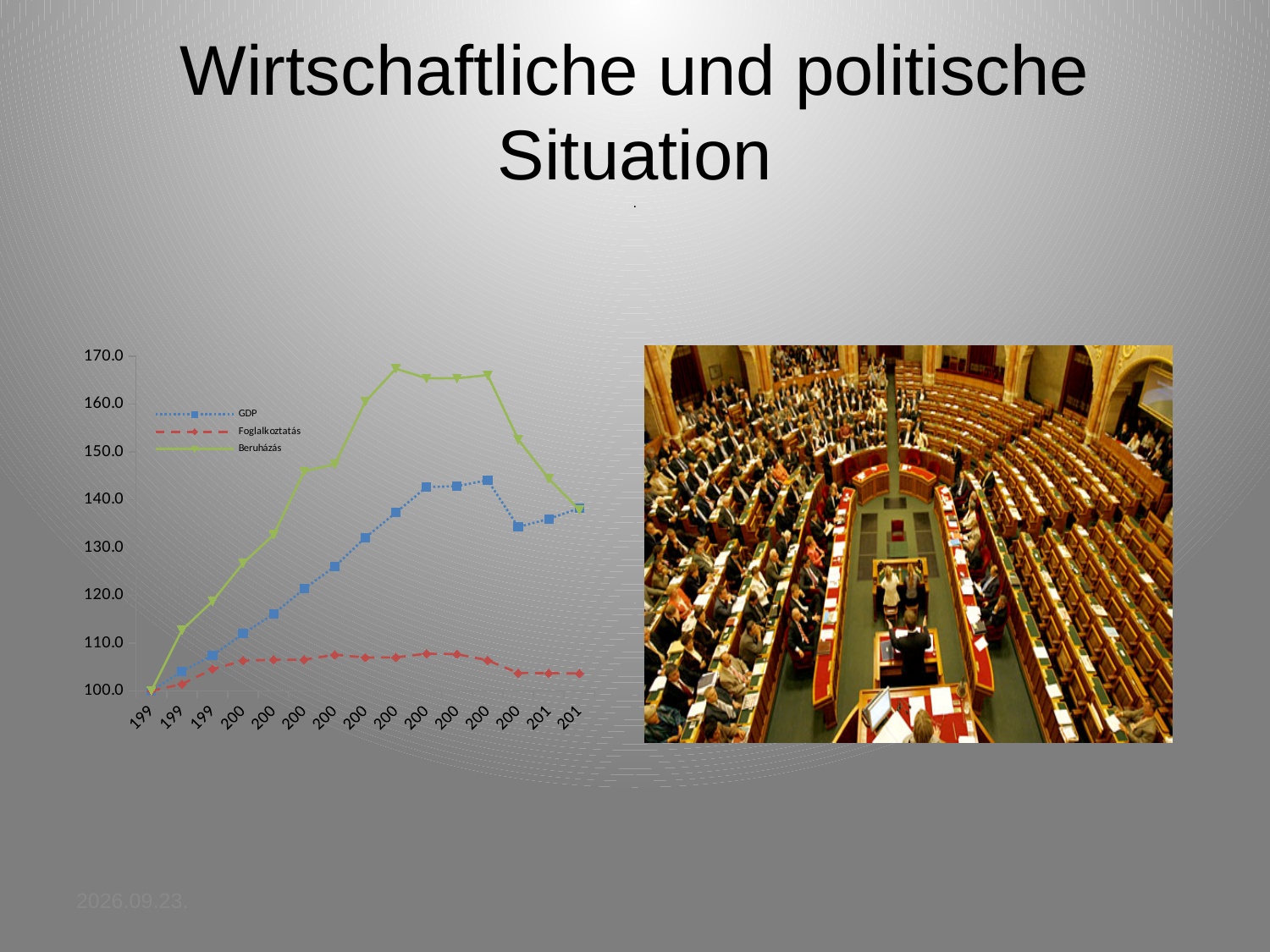
Is the peak value of the Beruházás series greater or less than 160.0? greater Does the Beruházás series end higher or lower than its peak value? lower Which series stays lowest across the whole chart? Foglalkoztatás Which colour is used for the Beruházás series in the chart? green Is the highest value of the Foglalkoztatás series greater or less than 110.0? less What kind of chart is shown on the slide? line chart How many series does the chart's legend list? 3 At what value do all three series start at the first point on the x axis? 100.0 How many data points does each series have along the x axis? 15 Which series reaches the highest value anywhere on the chart? Beruházás Is the highest value of the GDP series greater or less than 150.0? less What are the three series named in the chart's legend? GDP, Foglalkoztatás, Beruházás